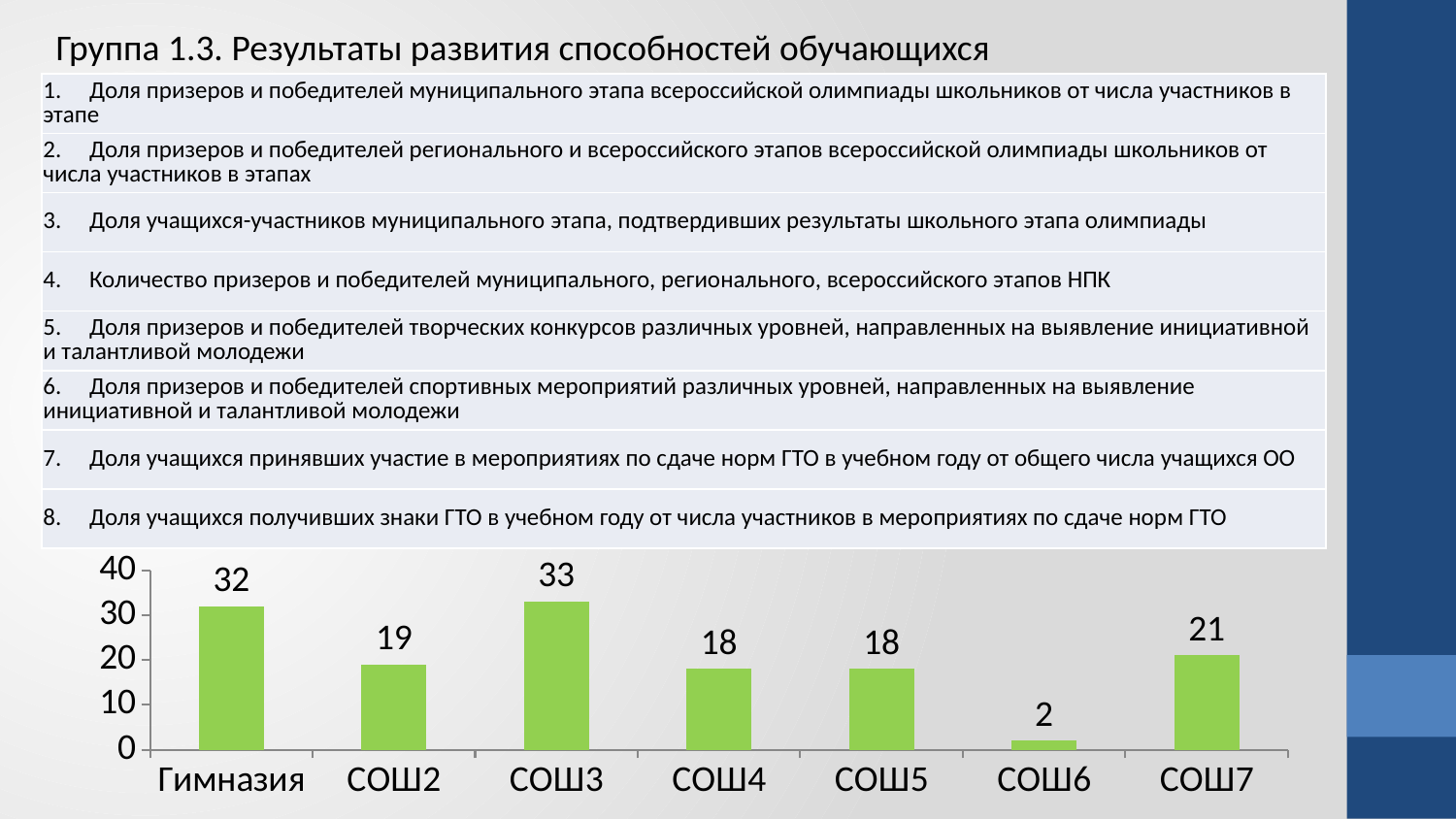
What is the value for СОШ6? 2 What kind of chart is shown on the slide? bar chart What is the difference between the values for СОШ7 and СОШ2? 2 How many categories are shown on the x axis of the chart? 7 Which is larger, the value for СОШ2 or the value for СОШ7? СОШ7 Which category has the lowest value? СОШ6 Is the value for СОШ4 greater or less than 10? greater What is the value for СОШ7? 21 What is the value for СОШ3? 33 What is the difference between the values for СОШ3 and СОШ6? 31 Which category has the highest value? СОШ3 What is the value for Гимназия? 32